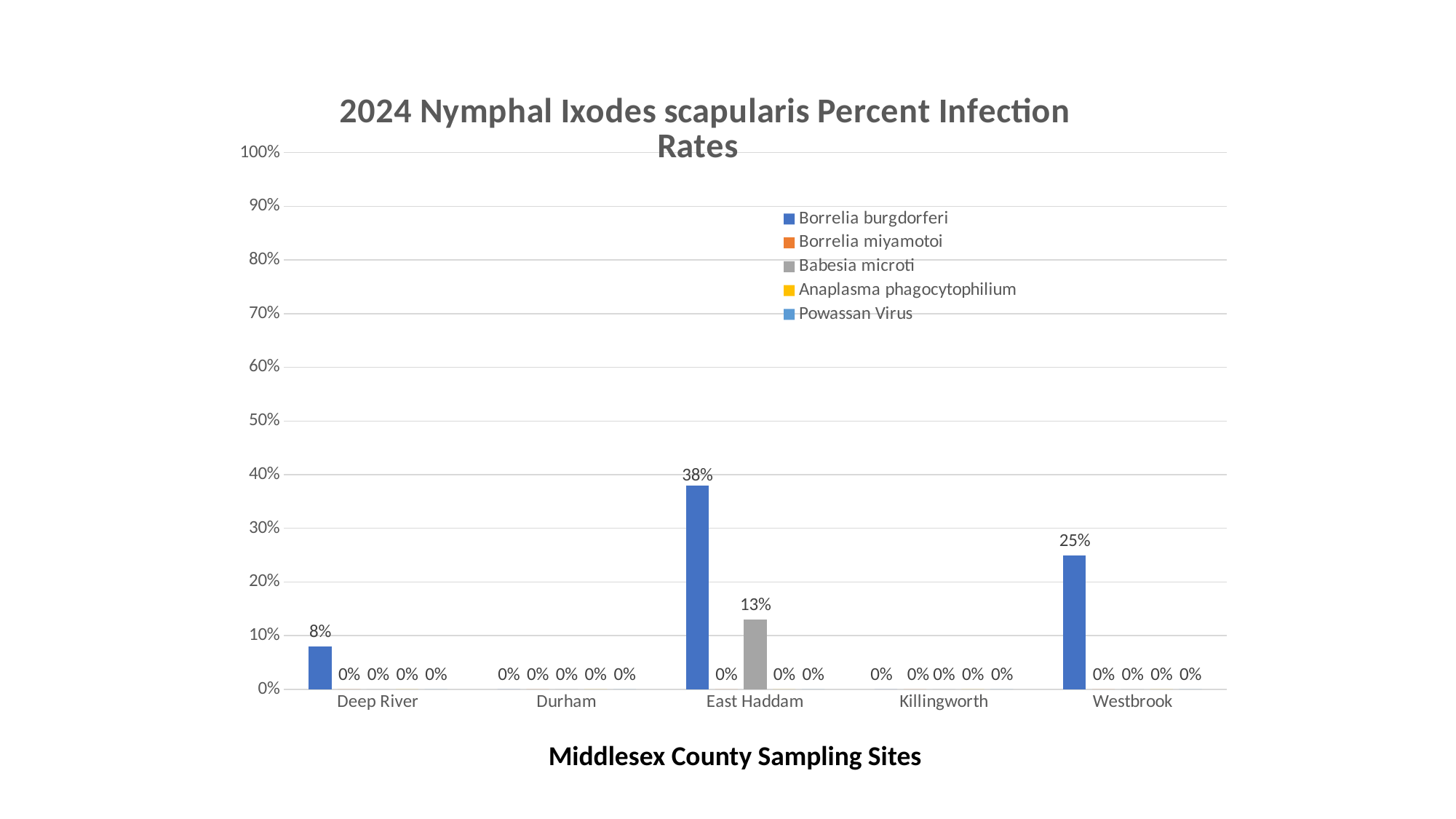
How many sampling sites are shown on the x axis? 5 What is the Babesia microti infection rate at East Haddam? 13% What kind of chart is shown on the slide? Bar chart What is the difference between the Borrelia burgdorferi rates at East Haddam and Westbrook? 13% What is the Borrelia burgdorferi infection rate at East Haddam? 38% What is the Borrelia burgdorferi infection rate at Deep River? 8% What is the Borrelia burgdorferi infection rate at Westbrook? 25% How many series does the legend list? 5 Which is larger at East Haddam: the Borrelia burgdorferi rate or the Babesia microti rate? Borrelia burgdorferi What is the Powassan Virus infection rate at Durham? 0% What is the x-axis title of the chart? Middlesex County Sampling Sites Which sampling site has the highest Borrelia burgdorferi infection rate? East Haddam